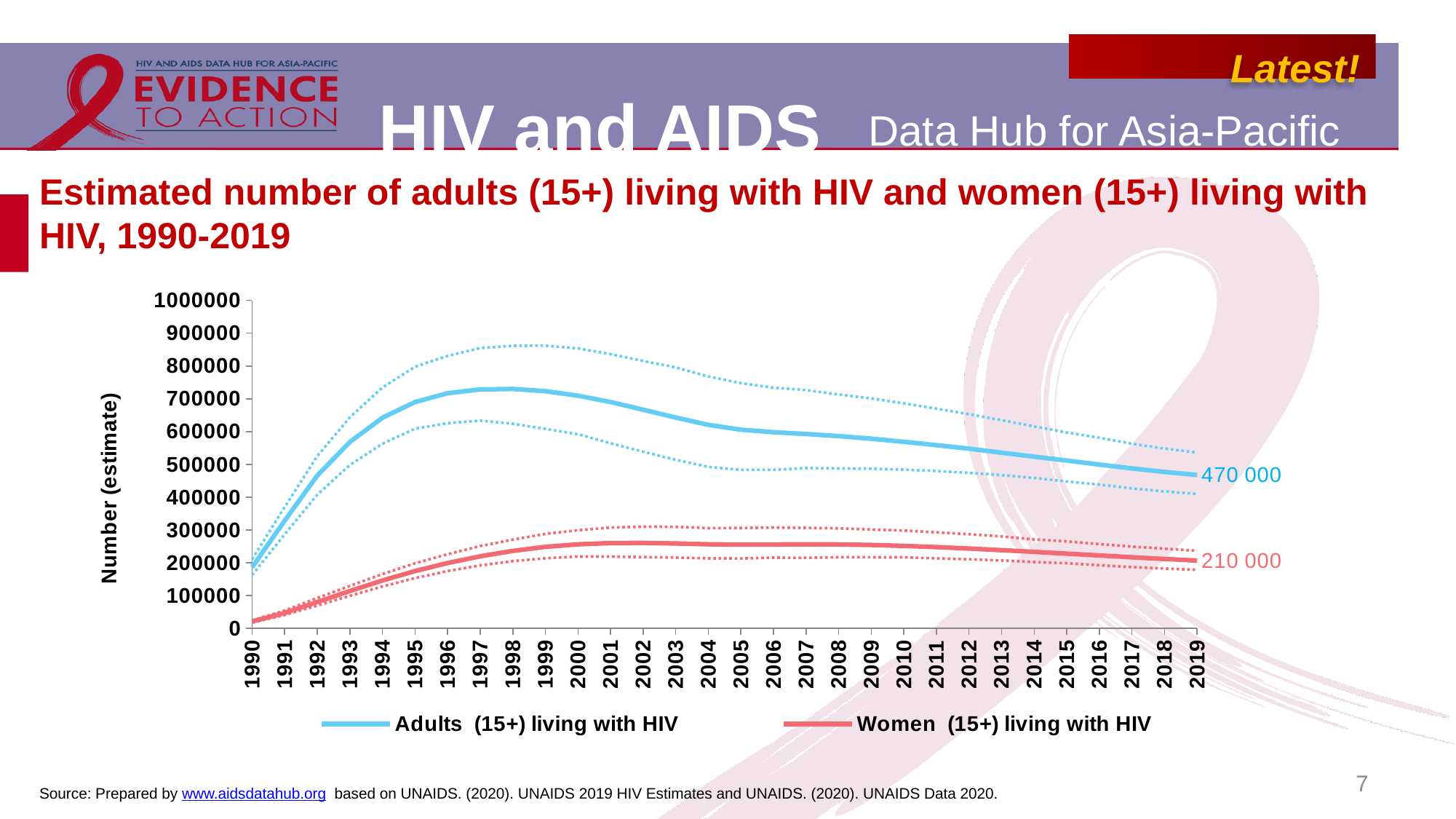
How many series does the legend list? 2 Does the number of adults (15+) living with HIV rise or fall between 2000 and 2019? fall What is the estimated number of women (15+) living with HIV in 2019? 210 000 Does the number of women (15+) living with HIV rise or fall between 1990 and 2000? rise What is the estimated number of adults (15+) living with HIV in 2019? 470 000 How many years are shown on the x axis of the chart? 30 Is the value for women (15+) living with HIV in 1990 greater or less than 100000? less What kind of chart is shown on the slide? line chart In 2019, which is larger: the number of adults (15+) living with HIV or the number of women (15+) living with HIV? Adults (15+) living with HIV What is the difference between the 2019 values for adults (15+) and women (15+) living with HIV? 260 000 What is the title of the y axis? Number (estimate) Is the value for adults (15+) living with HIV in 1997 greater or less than 600000? greater